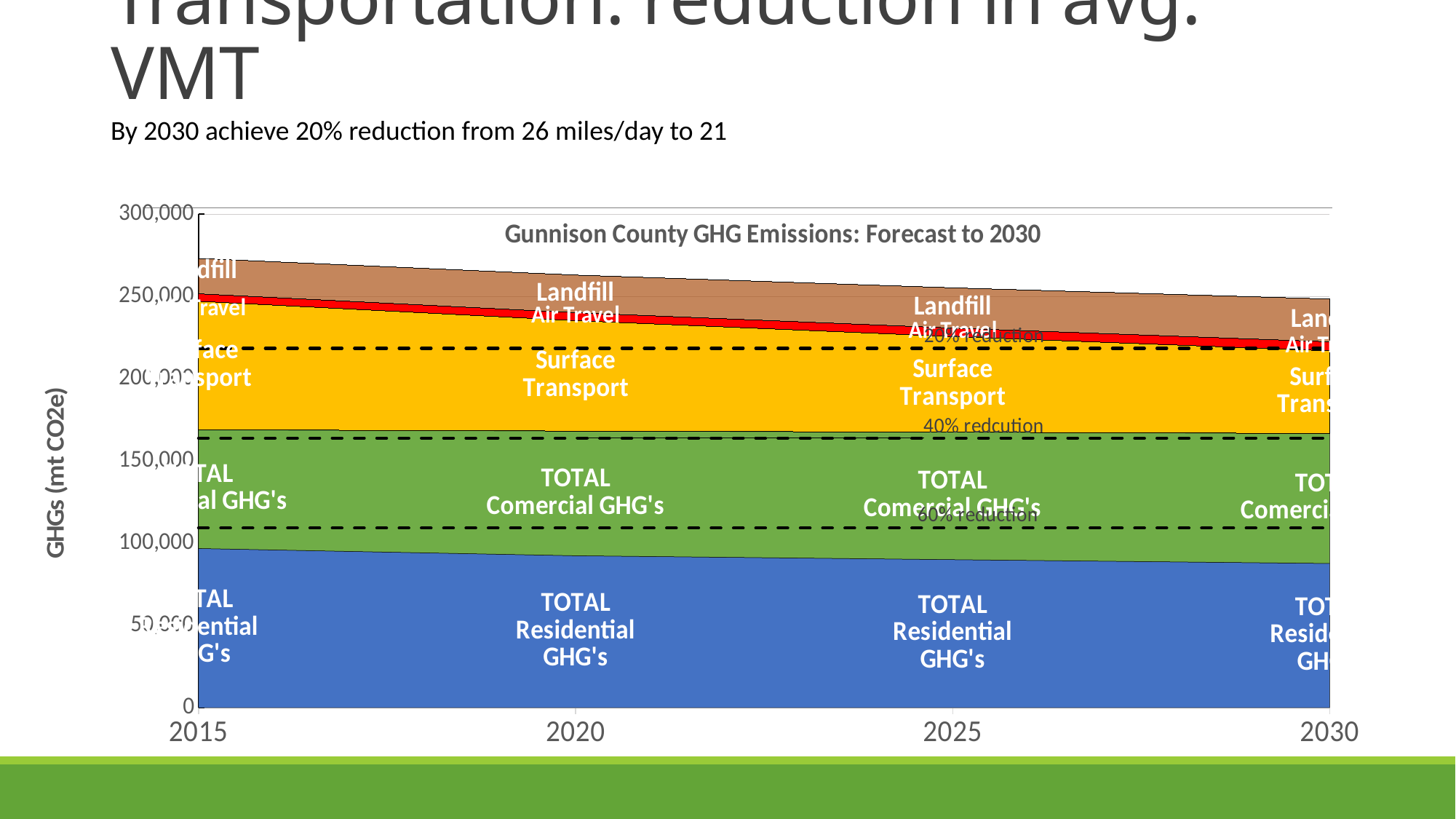
Which is larger in 2015, the TOTAL Residential GHG's band or the Air Travel band? TOTAL Residential GHG's Is the value for TOTAL Residential GHG's in 2030 greater or less than 100,000? less Is the total stacked emissions value in 2015 greater or less than 250,000? greater What kind of chart is shown on the slide? Stacked area chart How many years are labelled on the x axis of the chart? 4 Which emission category occupies the thinnest band in the chart? Air Travel What is the title of the chart? Gunnison County GHG Emissions: Forecast to 2030 Do total GHG emissions rise or fall from 2015 to 2030 in the chart? Fall What is the label on the vertical axis of the chart? GHGs (mt CO2e) Which category is plotted at the bottom of the stack in the chart? TOTAL Residential GHG's How many emission categories are stacked in the chart? 5